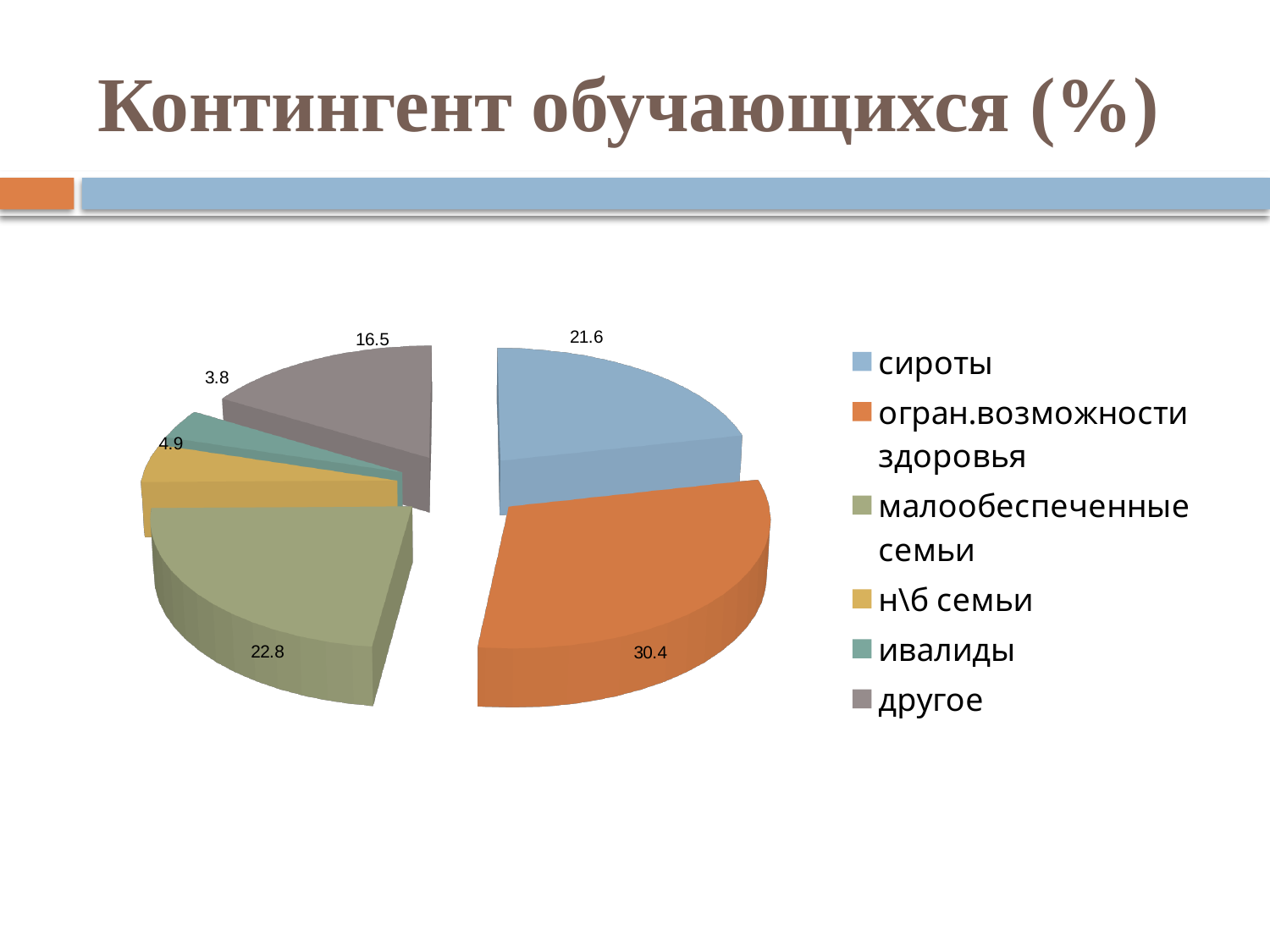
What is the title of the chart on the slide? Контингент обучающихся (%) Which category has the smallest slice? ивалиды What is the difference between the values for огран.возможности здоровья and сироты? 8.8 What is the value for другое? 16.5 What is the value for сироты? 21.6 Which is larger, the value for малообеспеченные семьи or the value for другое? малообеспеченные семьи What is the value for огран.возможности здоровья? 30.4 How many categories does the pie chart have? 6 What kind of chart is shown on the slide? pie chart What is the value for малообеспеченные семьи? 22.8 Which category has the largest slice? огран.возможности здоровья What is the value for н\б семьи? 4.9